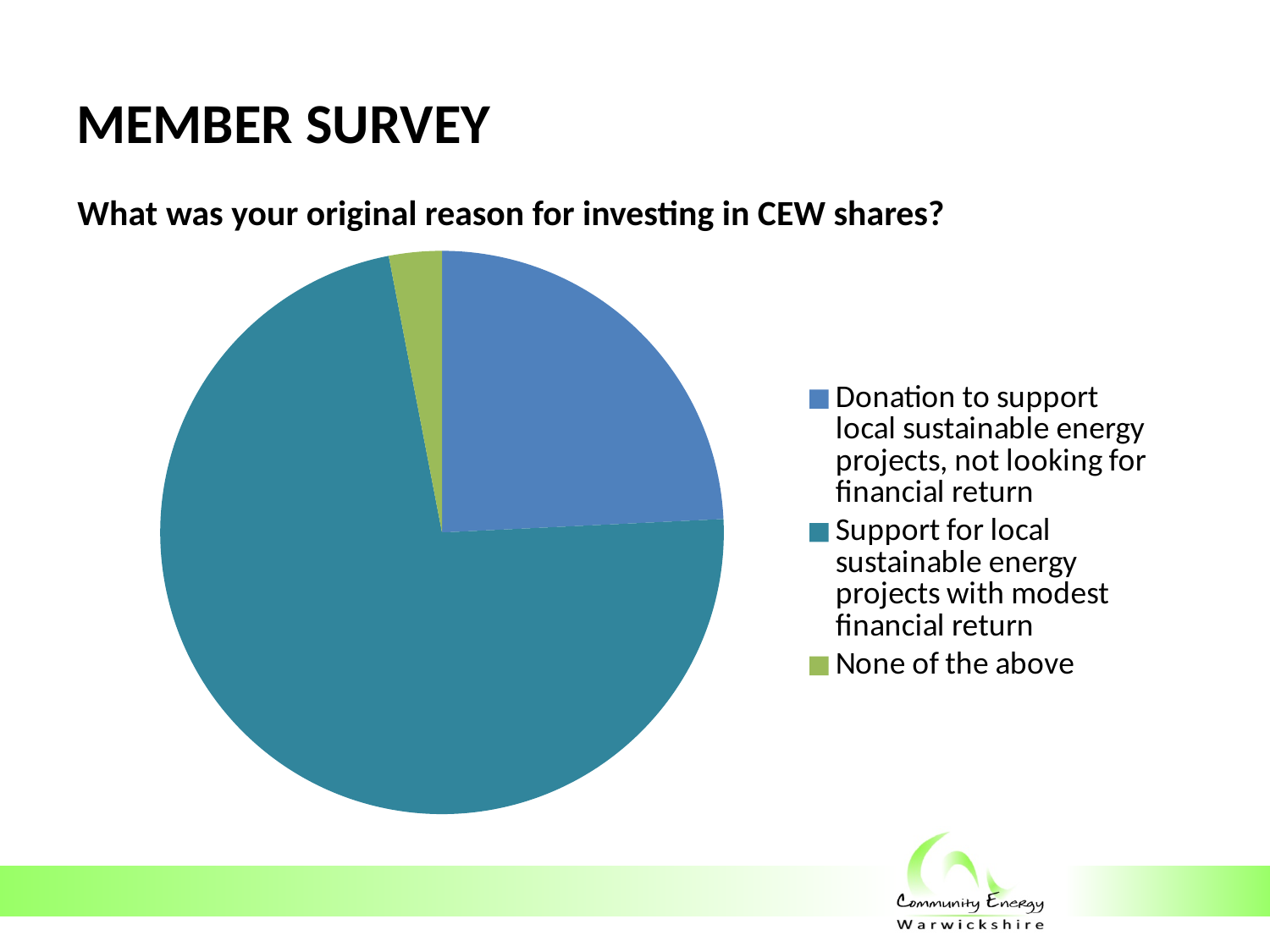
What kind of chart is shown on the slide? pie chart Which category has the largest slice of the pie? Support for local sustainable energy projects with modest financial return What survey question does the pie chart answer? What was your original reason for investing in CEW shares? Which category has the smallest slice of the pie? None of the above Which slice is larger: 'Support for local sustainable energy projects with modest financial return' or 'Donation to support local sustainable energy projects, not looking for financial return'? Support for local sustainable energy projects with modest financial return How many entries does the legend list? 3 How many slices does the pie chart have? 3 What colour is the slice for 'None of the above'? green Which slice is larger: 'Donation to support local sustainable energy projects, not looking for financial return' or 'None of the above'? Donation to support local sustainable energy projects, not looking for financial return